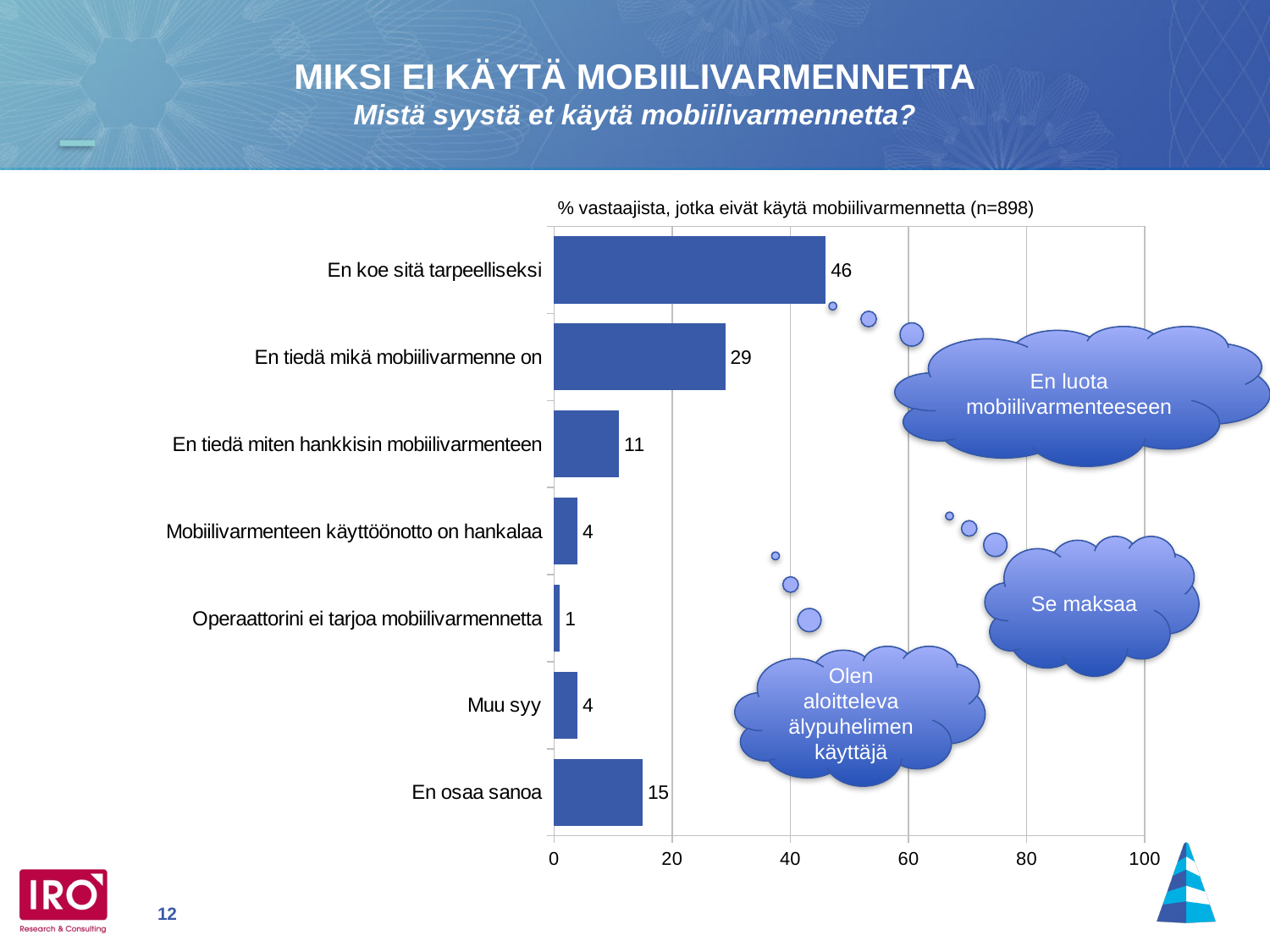
What is the sample size (n) stated in the chart's subtitle? 898 What is the value for "En koe sitä tarpeelliseksi"? 46 Is the value for "En koe sitä tarpeelliseksi" greater or less than 40? greater What is the value for "En osaa sanoa"? 15 Which category has the lowest value? Operaattorini ei tarjoa mobiilivarmennetta How many categories are shown in the chart? 7 Which category has the highest value? En koe sitä tarpeelliseksi Which is larger, the value for "En tiedä miten hankkisin mobiilivarmenteen" or the value for "En osaa sanoa"? En osaa sanoa What is the value for "En tiedä mikä mobiilivarmenne on"? 29 What kind of chart is shown on the slide? bar chart What is the difference between the values for "En koe sitä tarpeelliseksi" and "En tiedä mikä mobiilivarmenne on"? 17 What is the value for "Operaattorini ei tarjoa mobiilivarmennetta"? 1